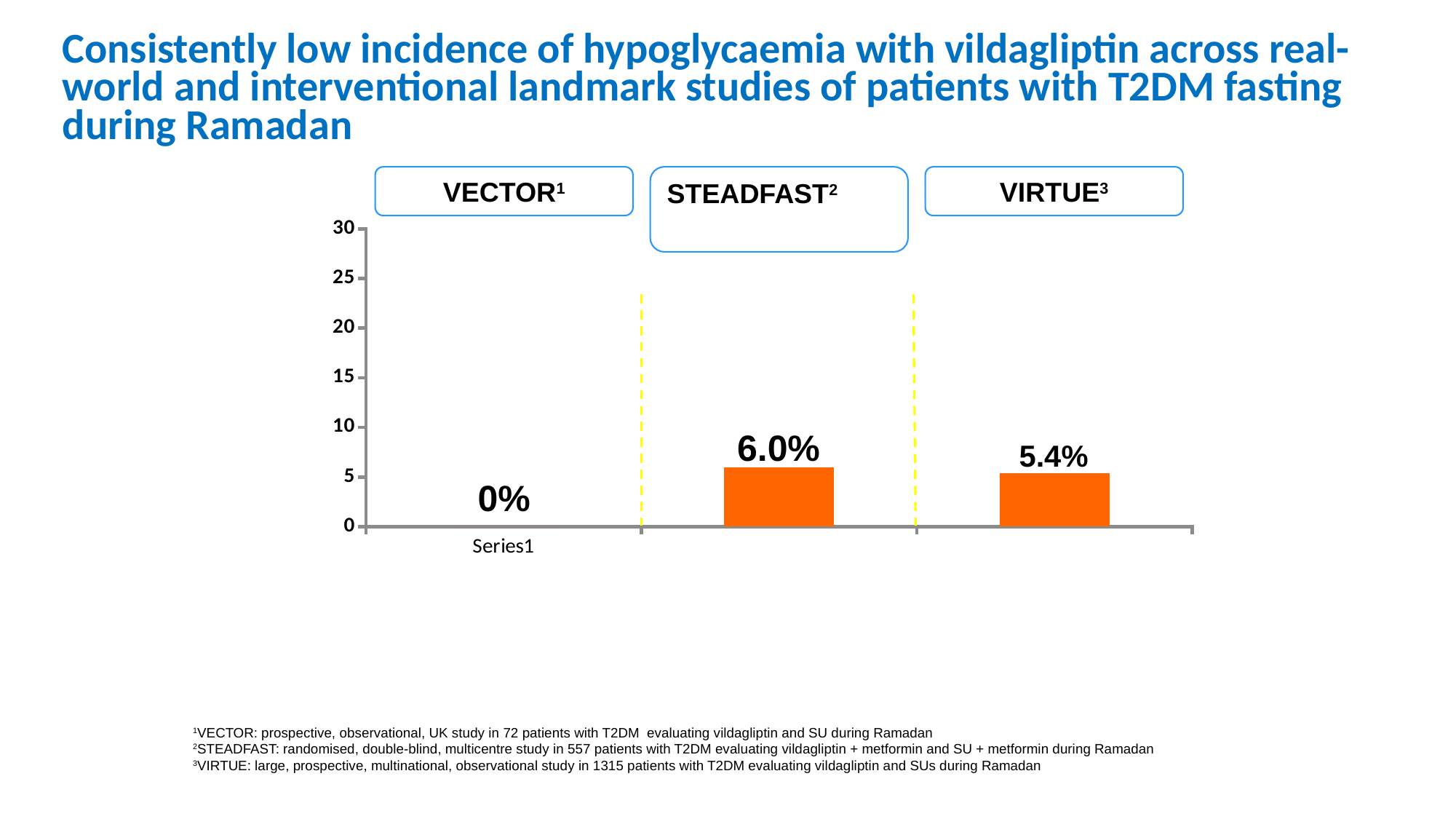
What is the difference between the STEADFAST and VIRTUE incidence values? 0.6% What colour are the bars in the chart? orange What is the hypoglycaemia incidence shown for the VIRTUE study? 5.4% What kind of chart is shown on the slide? bar chart Which study has the lowest hypoglycaemia incidence on the chart? VECTOR Is the value for STEADFAST greater or less than 10? less What is the hypoglycaemia incidence shown for the VECTOR study? 0% What is the hypoglycaemia incidence shown for the STEADFAST study? 6.0% How many studies are shown on the chart? 3 Which is larger, the incidence for STEADFAST or for VIRTUE? STEADFAST What is the maximum value shown on the vertical axis of the chart? 30 Which study has the highest hypoglycaemia incidence on the chart? STEADFAST